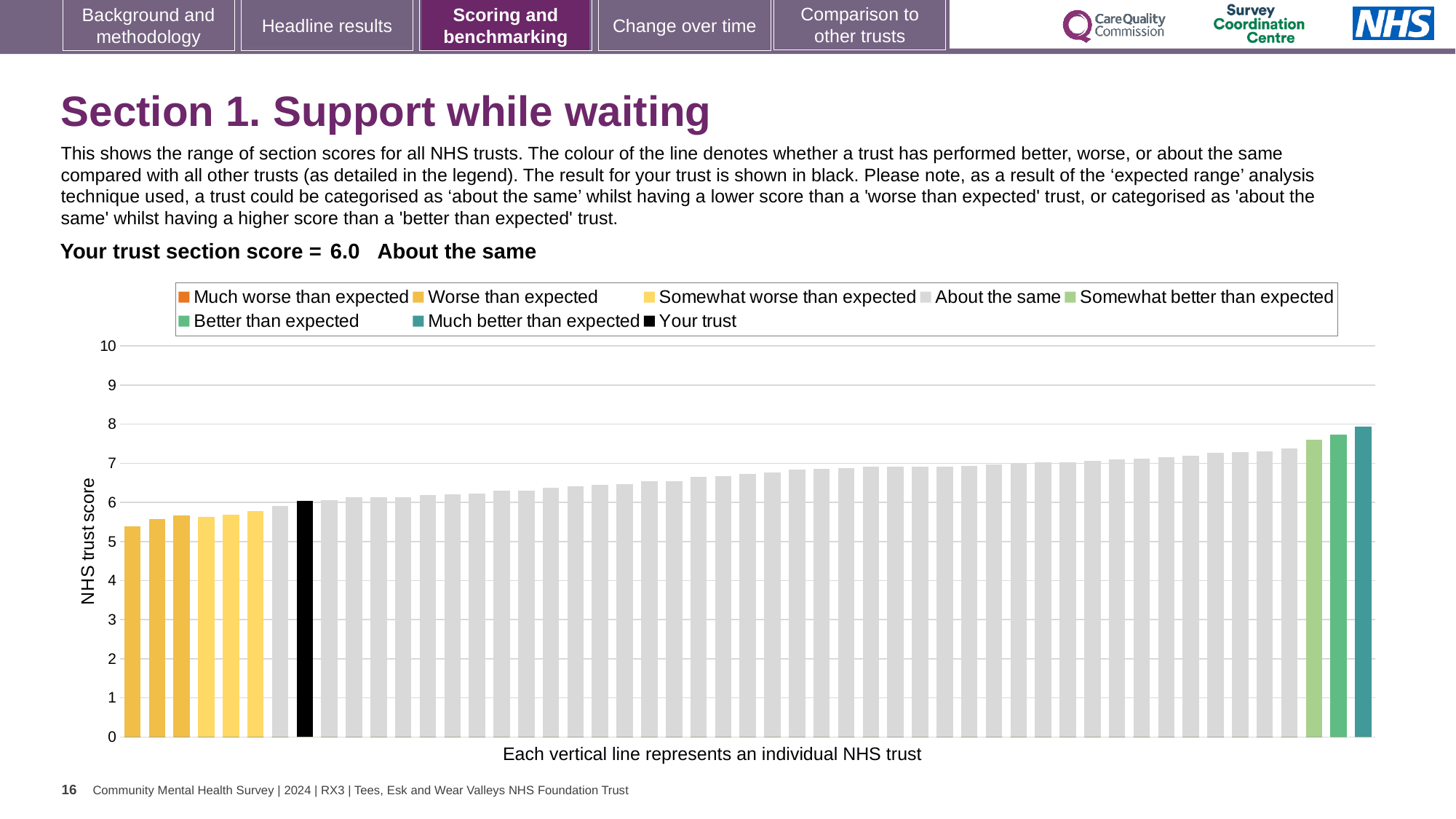
What is the label on the vertical axis of the chart? NHS trust score Which legend category does the tallest bar on the chart belong to? Much better than expected How many entries does the chart legend list? 8 What kind of chart is shown on the slide? bar chart Which legend category does the shortest bar on the chart belong to? Worse than expected How is your trust categorised relative to other trusts for this section? About the same Is the lowest bar on the chart greater or less than 6? less What is the section score for your trust shown on the slide? 6.0 Is the score for your trust (the black bar) greater or less than 5? greater Do the bar values rise or fall from left to right along the x axis? rise Is the highest bar on the chart greater or less than 7? greater How many bars are coloured as 'Worse than expected'? 3